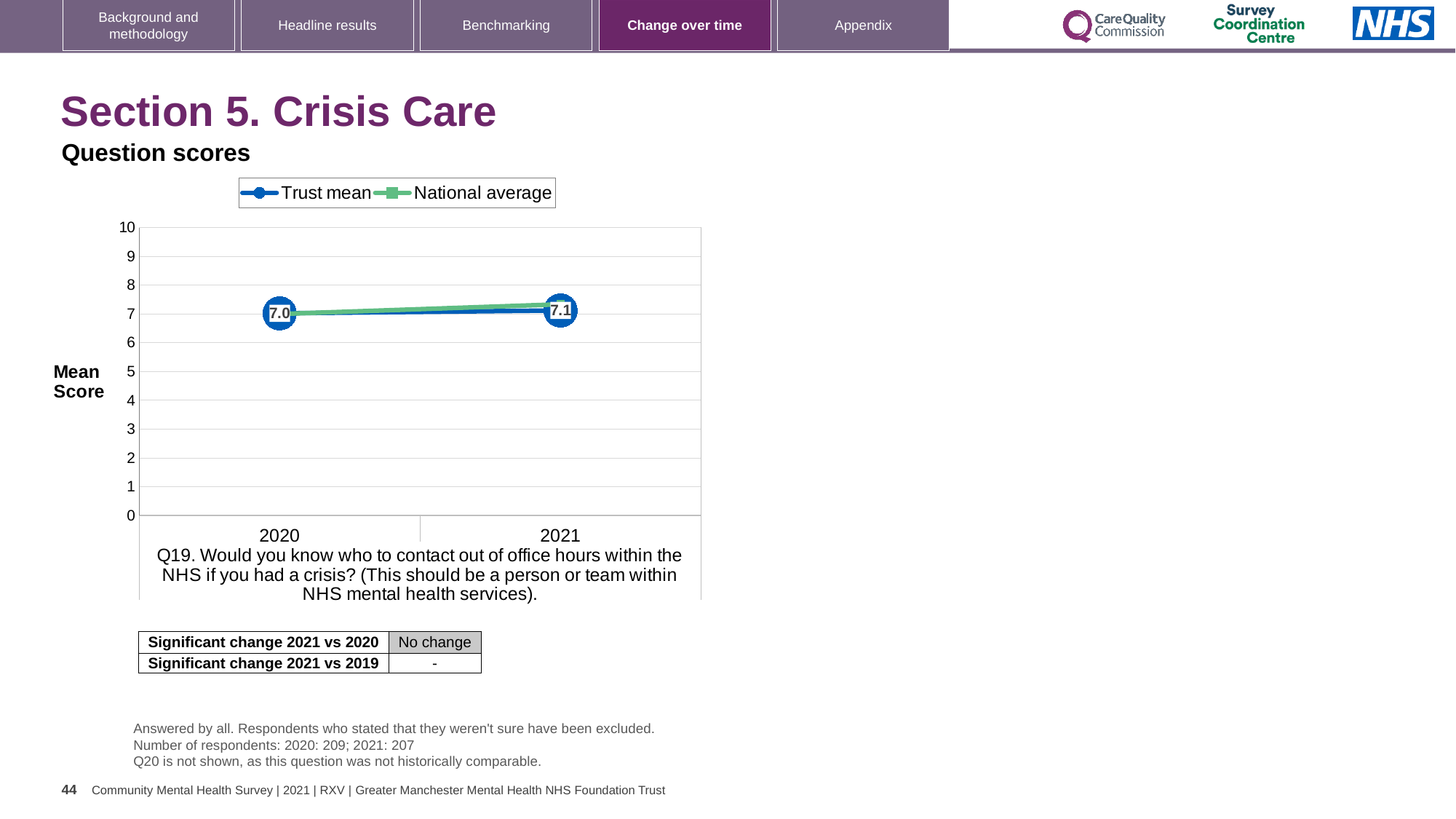
What is the label on the y axis of the chart? Mean Score Which year has the higher Trust mean score, 2020 or 2021? 2021 What kind of chart is shown on the slide? line chart How many years are plotted on the x axis of the chart? 2 What is the Trust mean score for 2021? 7.1 Is the National average value for 2021 greater or less than 5? greater What is the Trust mean score for 2020? 7.0 In which year is the Trust mean score lowest? 2020 Does the Trust mean score rise or fall from 2020 to 2021? rise What are the two series named in the chart legend? Trust mean and National average How many series does the chart legend list? 2 What is the difference between the Trust mean scores for 2021 and 2020? 0.1